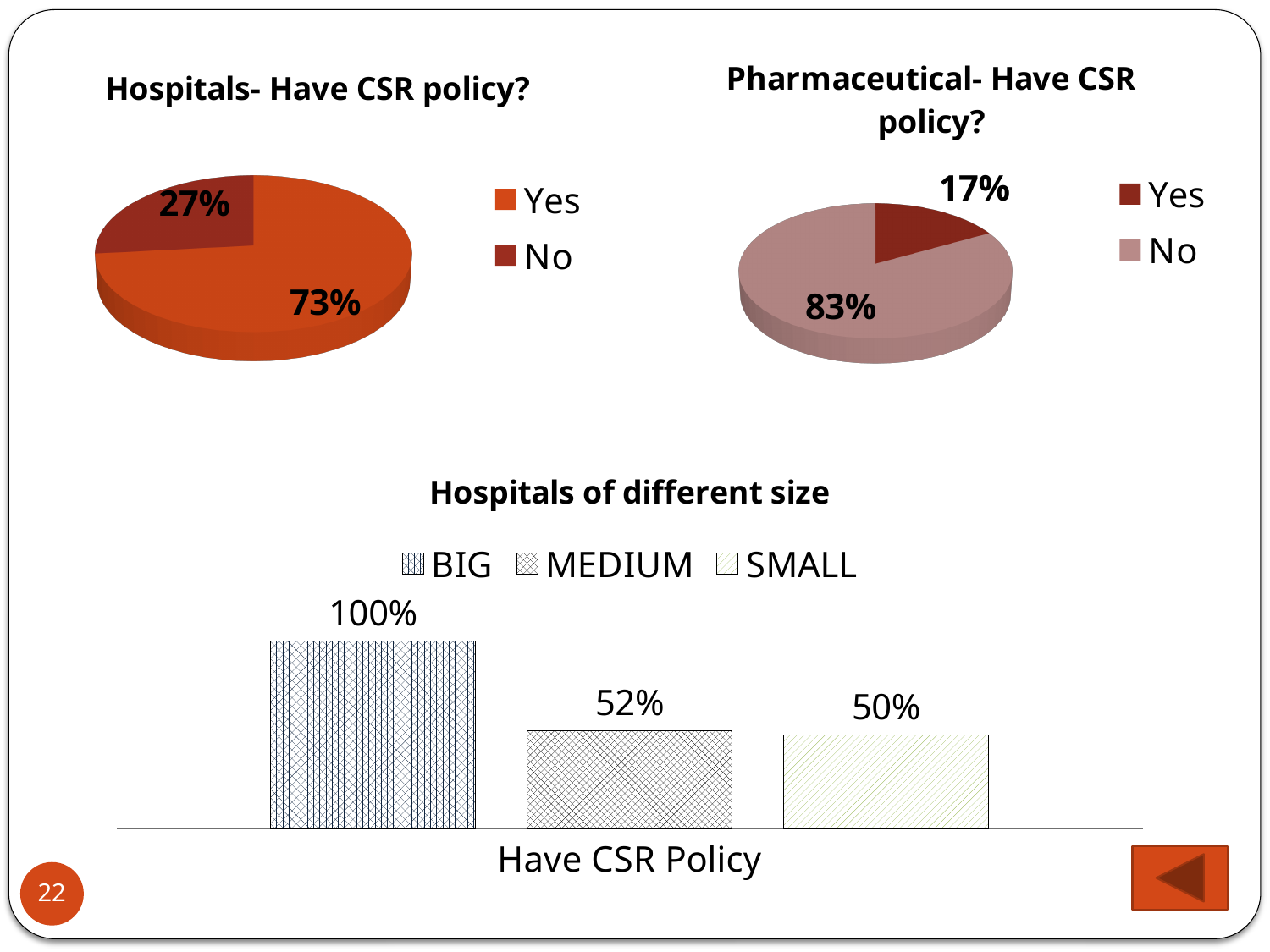
In the 'Hospitals of different size' chart, what is the value for MEDIUM? 52% In the 'Pharmaceutical- Have CSR policy?' chart, which slice is larger, Yes or No? No In the 'Hospitals of different size' chart, what is the difference between BIG and MEDIUM? 48% In the 'Hospitals of different size' chart, which series has the highest value? BIG How many series does the legend of the 'Hospitals of different size' chart list? 3 In the 'Pharmaceutical- Have CSR policy?' chart, what percentage answered Yes? 17% What kind of chart is 'Hospitals- Have CSR policy?'? Pie chart In the 'Pharmaceutical- Have CSR policy?' chart, what percentage answered No? 83% What kind of chart is 'Hospitals of different size'? Bar chart In the 'Hospitals of different size' chart, what is the value for SMALL? 50% In the 'Hospitals- Have CSR policy?' chart, what percentage answered Yes? 73% In the 'Hospitals- Have CSR policy?' chart, what percentage answered No? 27%